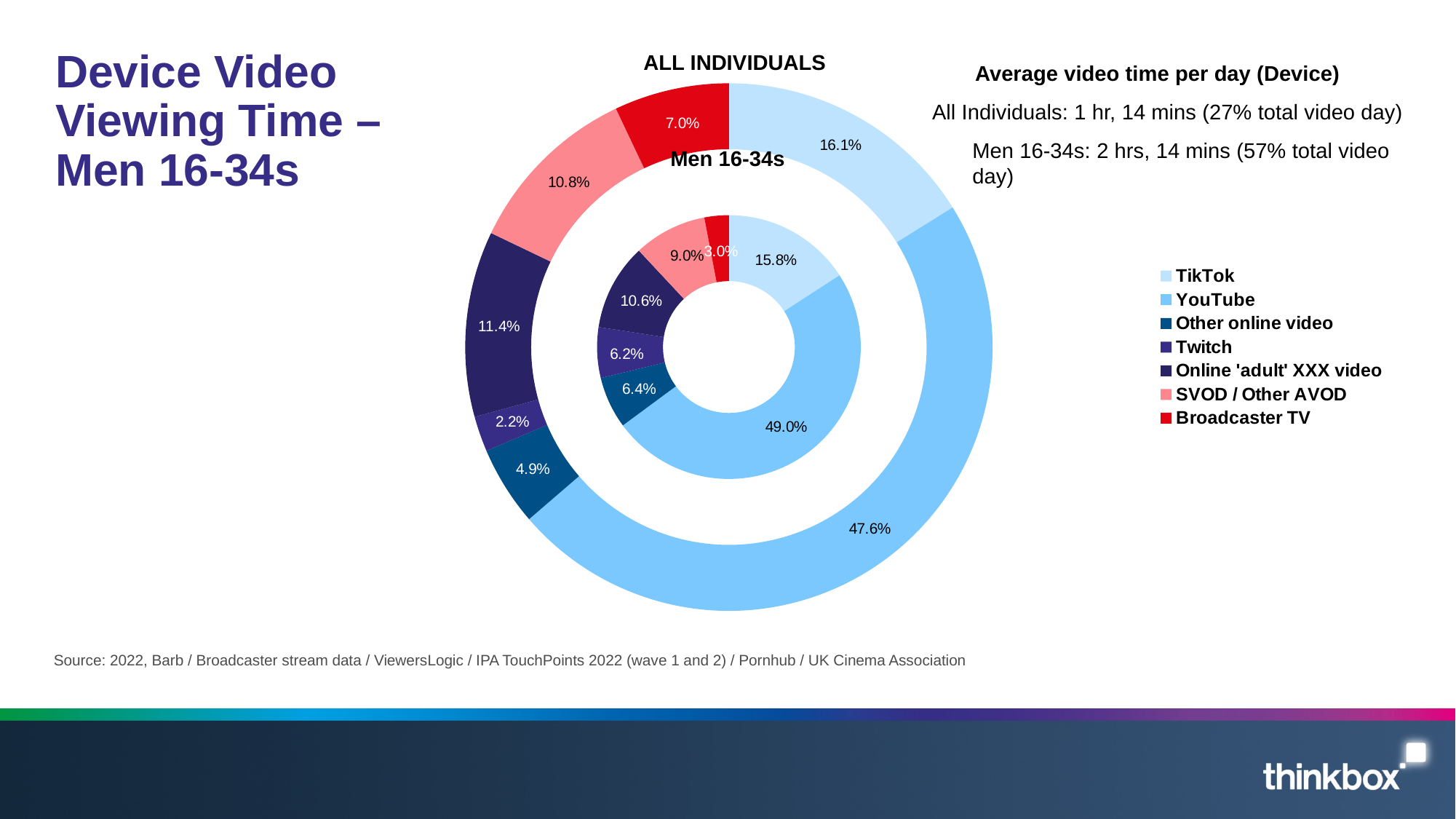
What share of the Men 16-34s ring is Twitch? 6.2% How many categories does the legend list? 7 What is the difference between the Twitch share for Men 16-34s and for All Individuals? 4.0% Which is larger: the Broadcaster TV share for All Individuals or for Men 16-34s? All Individuals What share of the All Individuals ring is YouTube? 47.6% What share of the All Individuals ring is Broadcaster TV? 7.0% What kind of chart is shown on the slide? Doughnut chart Which ring of the doughnut chart represents All Individuals, the outer or the inner? Outer Which category has the largest share in the Men 16-34s ring? YouTube What is the difference between the SVOD / Other AVOD share for All Individuals and for Men 16-34s? 1.8% Which category has the smallest share in the All Individuals ring? Twitch What share of the Men 16-34s ring is Online 'adult' XXX video? 10.6%